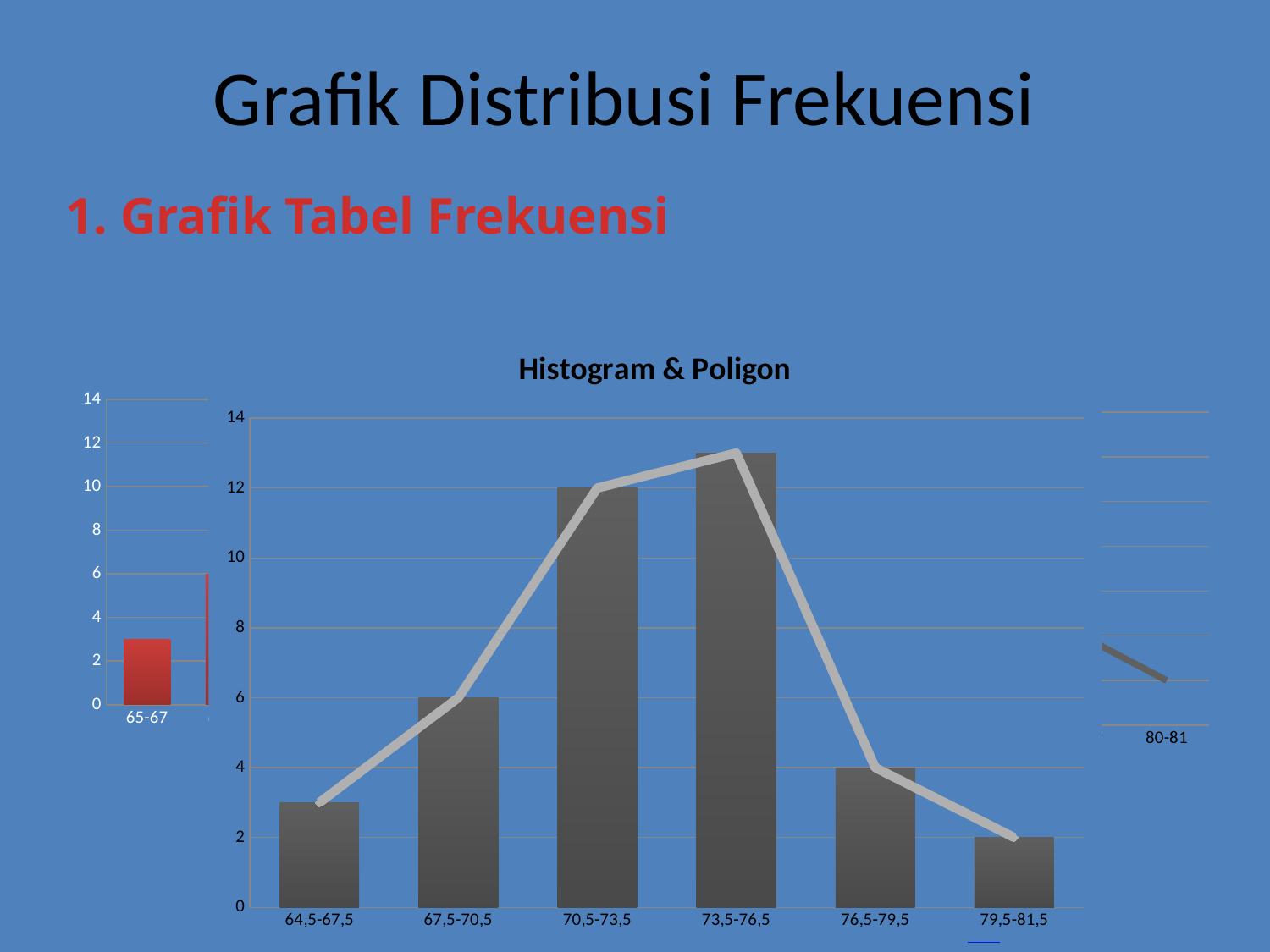
In the 'Histogram & Poligon' chart, is the value for 64,5-67,5 greater or less than 4? less In the 'Histogram & Poligon' chart, which class has the lowest value? 79,5-81,5 In the 'Histogram & Poligon' chart, what is the value for the 79,5-81,5 class? 2 In the 'Histogram & Poligon' chart, which class has the highest value? 73,5-76,5 In the 'Histogram & Poligon' chart, is the value for 73,5-76,5 greater or less than 12? greater In the 'Histogram & Poligon' chart, what is the value for the 70,5-73,5 class? 12 In the 'Histogram & Poligon' chart, what is the value for the 67,5-70,5 class? 6 In the 'Histogram & Poligon' chart, which is larger: the value for 76,5-79,5 or the value for 79,5-81,5? 76,5-79,5 How many class intervals are shown on the x axis of the 'Histogram & Poligon' chart? 6 In the 'Histogram & Poligon' chart, what is the value for the 76,5-79,5 class? 4 In the 'Histogram & Poligon' chart, what is the difference between the values for 70,5-73,5 and 67,5-70,5? 6 What is the title of the large chart on the slide? Histogram & Poligon